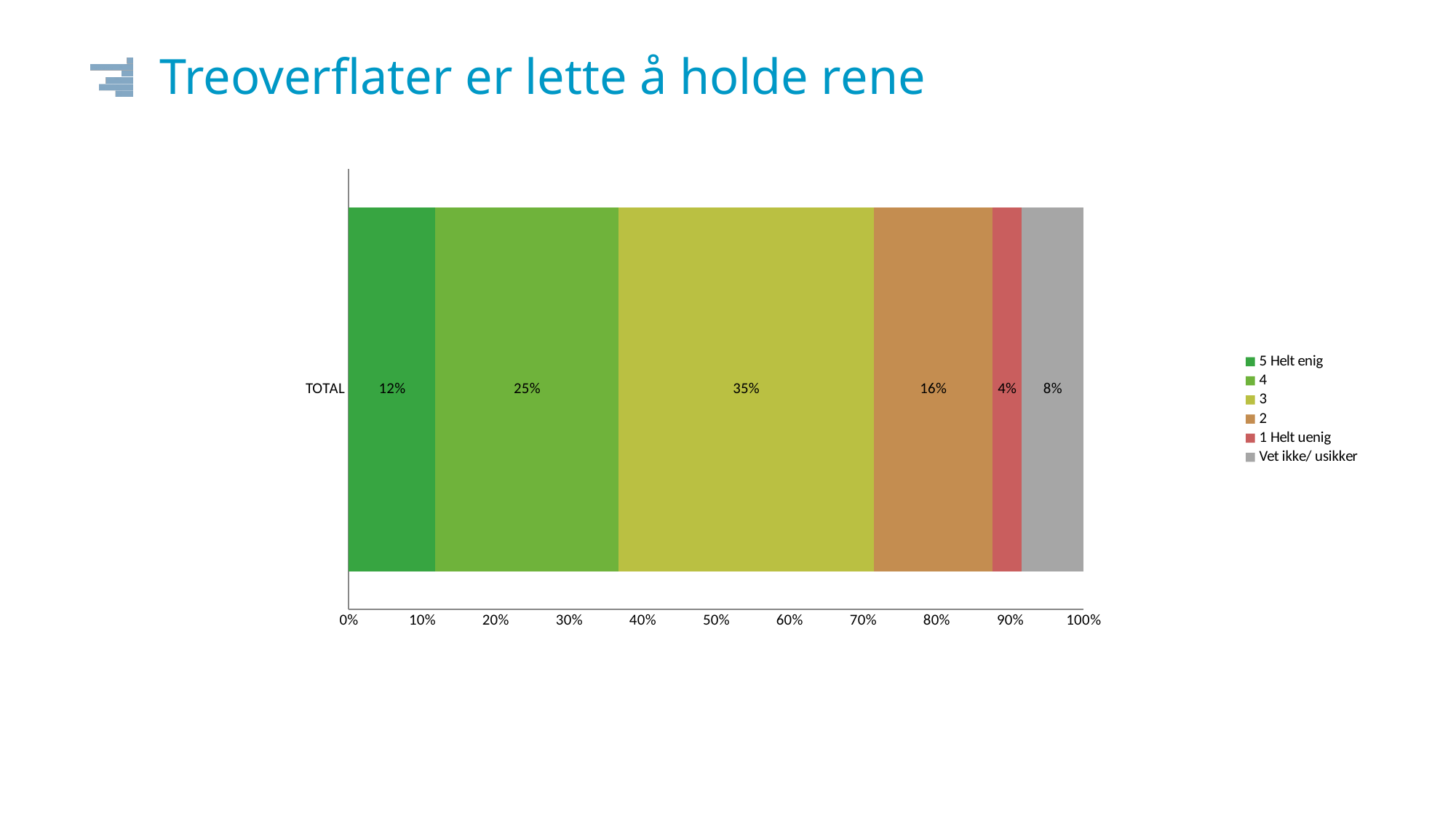
What kind of chart is shown on the slide? Stacked bar chart What is the total of the "5 Helt enig" and "4" segments combined? 37% Which response category has the smallest share in the TOTAL bar? 1 Helt uenig What percentage of respondents answered "1 Helt uenig" for TOTAL? 4% What percentage of respondents answered "Vet ikke/ usikker" for TOTAL? 8% What percentage of respondents answered "3" for TOTAL? 35% How many series does the legend list? 6 Which response category has the largest share in the TOTAL bar? 3 What is the difference in percentage points between the "4" and "2" segments? 9 Which is larger, the "5 Helt enig" segment or the "2" segment? 2 What is the title of the slide? Treoverflater er lette å holde rene What percentage of respondents answered "5 Helt enig" for TOTAL? 12%